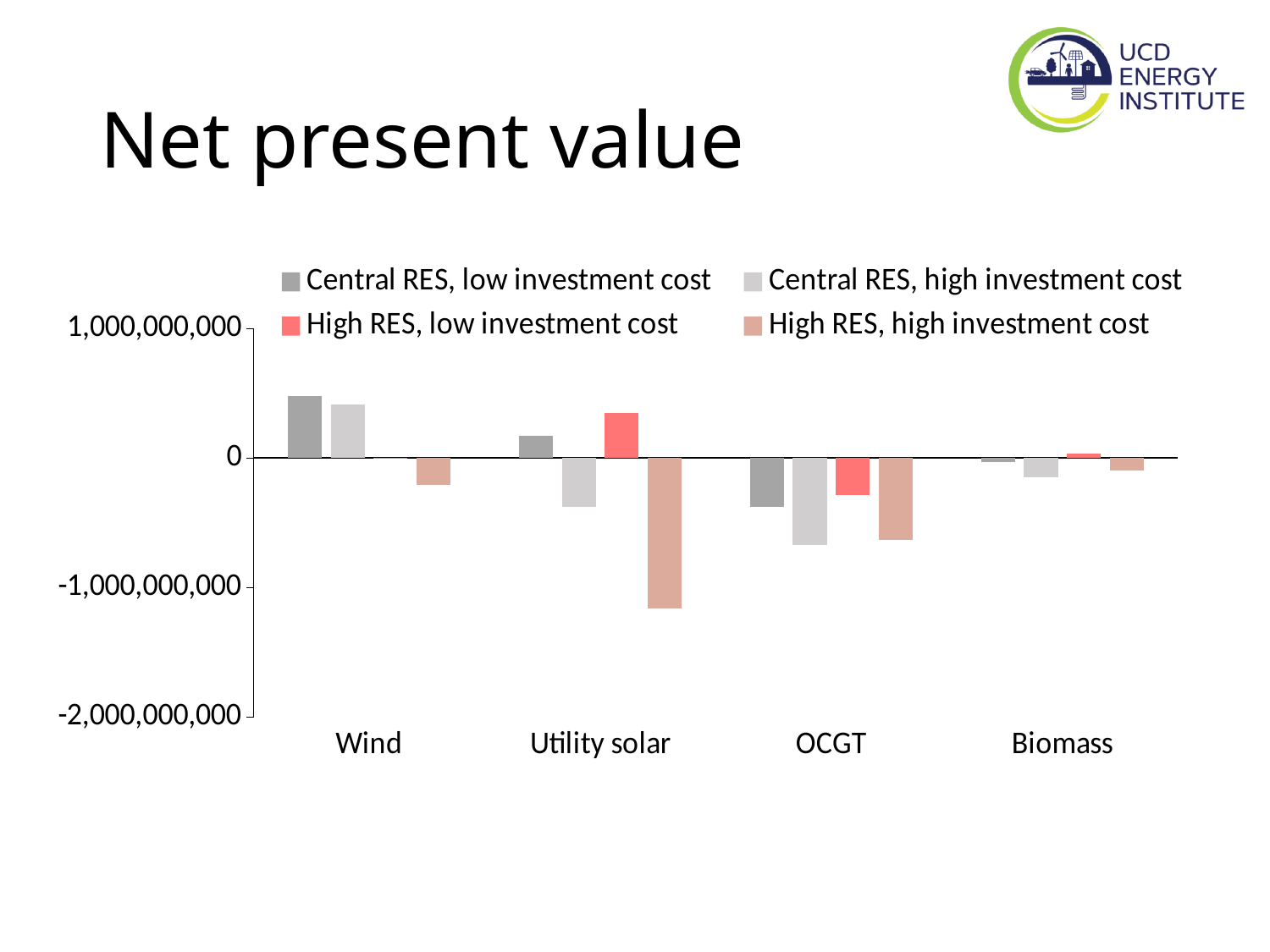
Is the value for OCGT in the Central RES, high investment cost series greater or less than -1,000,000,000? greater What is the title of the slide's chart? Net present value How many categories are shown on the x axis? 4 Is the value for Utility solar in the High RES, high investment cost series greater or less than -1,000,000,000? less Is the value for OCGT in the Central RES, high investment cost series greater or less than 0? less Which category has the lowest value for the High RES, high investment cost series? Utility solar How many series does the legend list? 4 Which category has the lowest value for the Central RES, high investment cost series? OCGT What kind of chart is shown on the slide? bar chart Which is larger, the High RES, low investment cost value for Utility solar or for OCGT? Utility solar Which is larger, the Central RES, low investment cost value for Wind or for OCGT? Wind